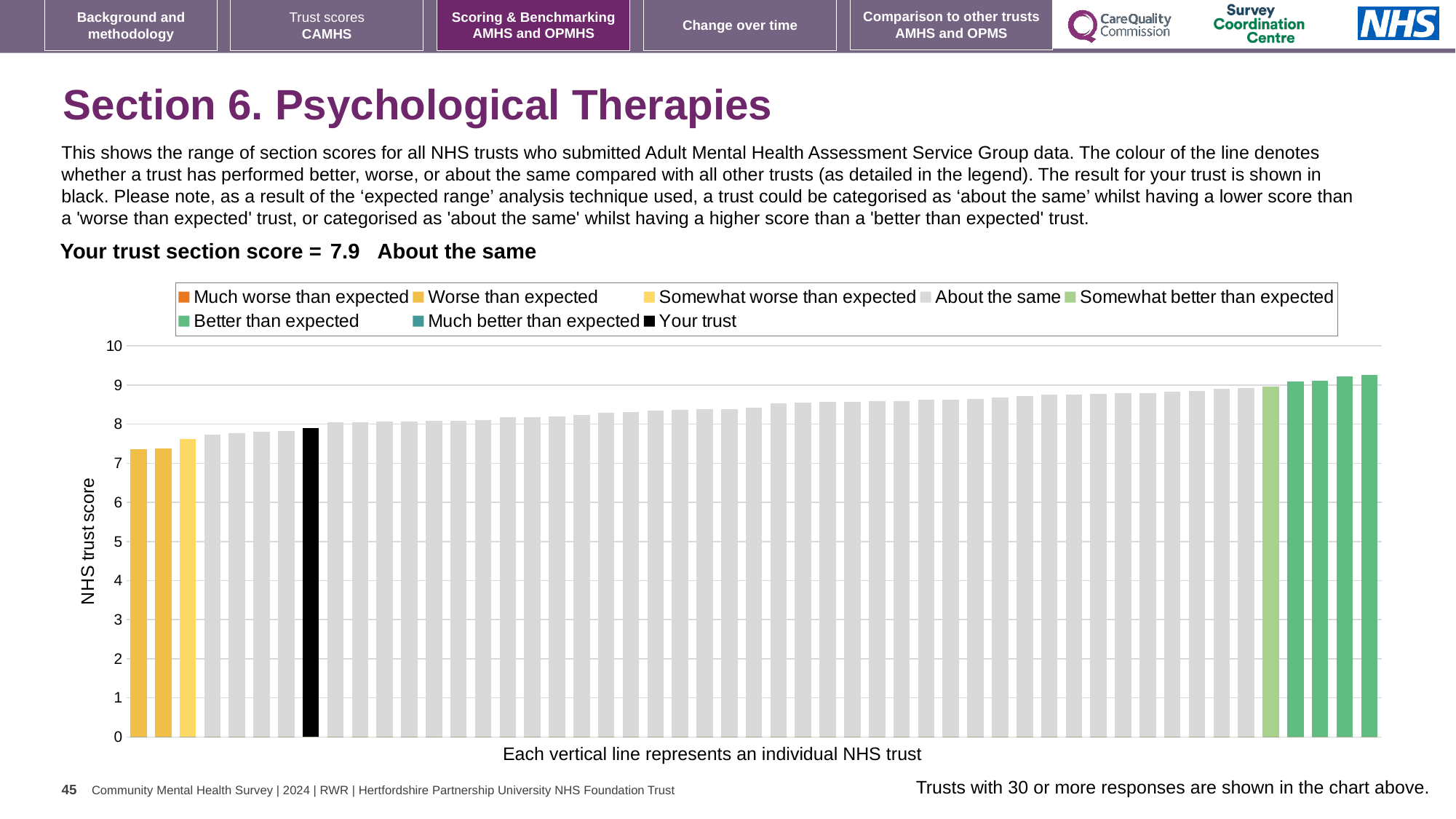
Which performance category is your trust placed in for this section? About the same Is the value of the leftmost (lowest) bar greater or less than 8? less Which is taller, the leftmost bar or the rightmost bar? the rightmost bar What is the section score for your trust shown on the slide? 7.9 Is the value of the black 'Your trust' bar greater or less than 7? greater What is the label on the vertical axis of the chart? NHS trust score How many entries does the chart legend list? 8 Do the bar values rise or fall moving from left to right along the x axis? rise How many bars are positioned to the left of the black 'Your trust' bar? 7 What kind of chart is shown on the slide? bar chart Which legend category do the tallest bars in the chart belong to? Better than expected Is the value of the rightmost (highest) bar greater or less than 9? greater